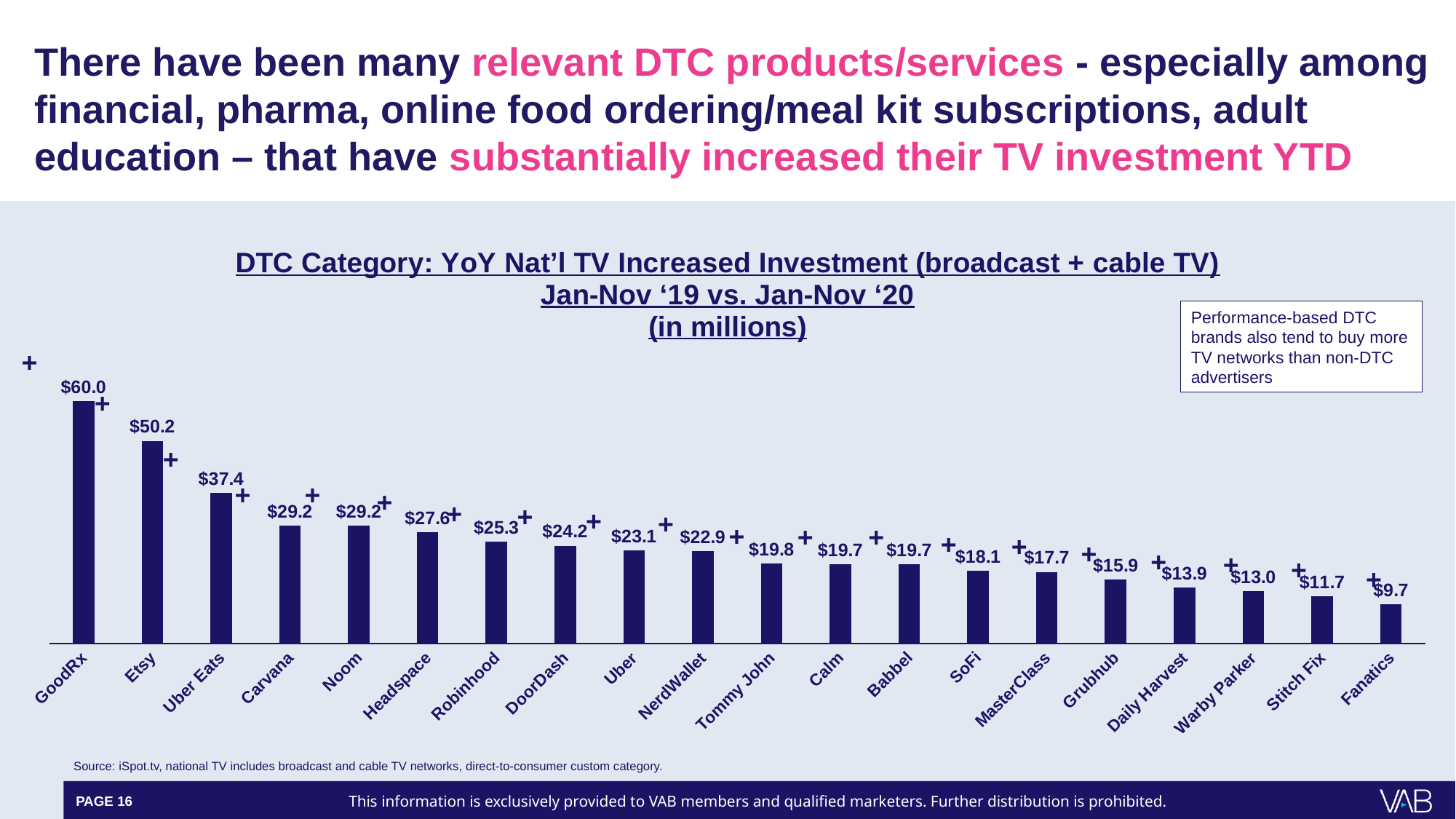
What kind of chart is shown on the slide? Bar chart What is the difference between the values for GoodRx and Etsy? $9.8 What is the value shown for Robinhood? $25.3 Which has a larger value, DoorDash or Grubhub? DoorDash Do the values rise or fall moving from left to right along the x axis? Fall Which brand has the highest value in the chart? GoodRx What is the difference between the values for Uber Eats and Fanatics? $27.7 What is the value shown for GoodRx? $60.0 Which brand has the lowest value in the chart? Fanatics What is the value shown for Warby Parker? $13.0 In what units are the chart values expressed, according to the title? In millions How many brands are shown in the chart? 20